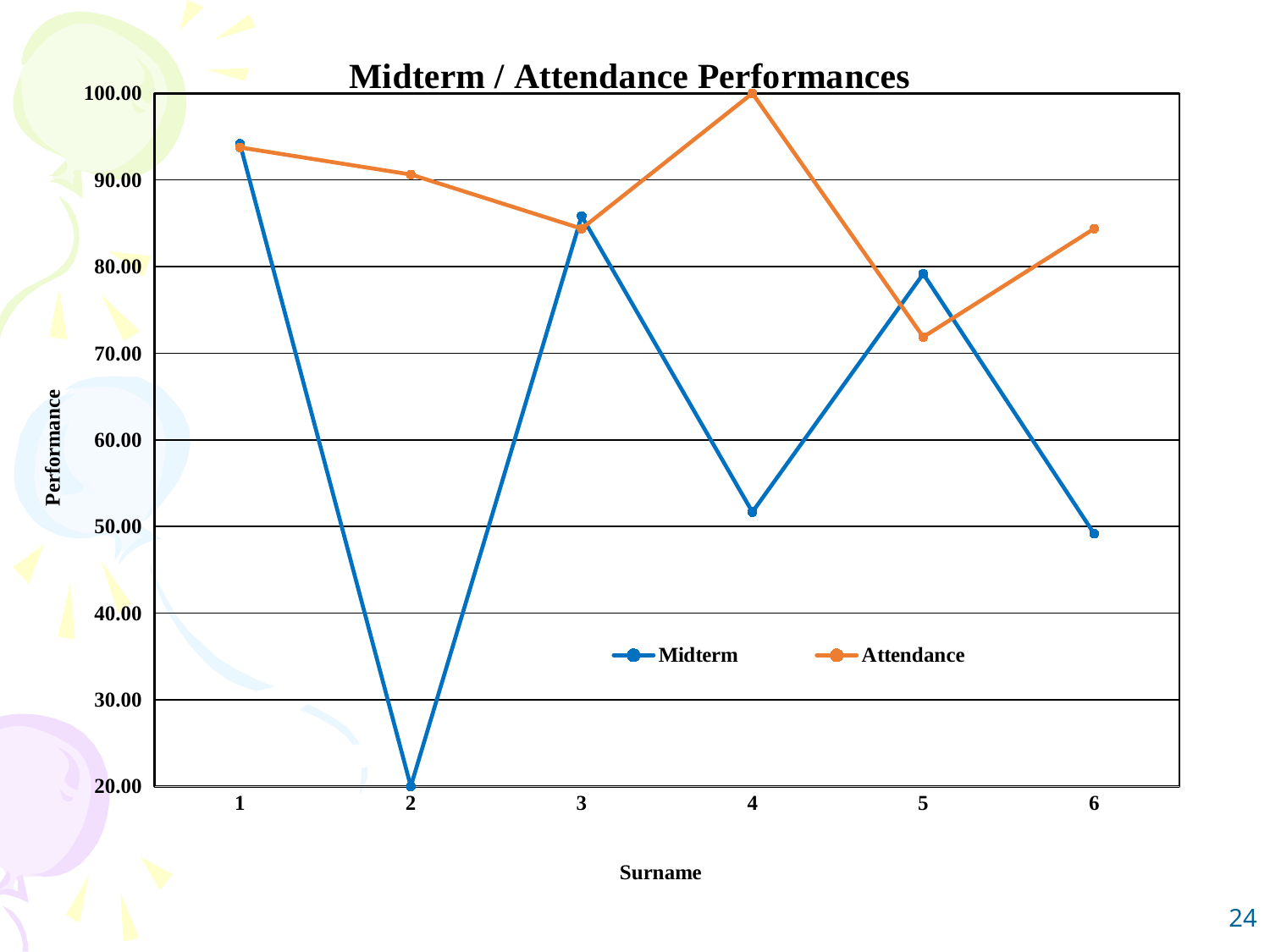
For which surname number is the Attendance value highest? 4 Which is larger for surname number 6, the Midterm value or the Attendance value? Attendance For which surname number is the Midterm value lowest? 2 What is the title of the chart? Midterm / Attendance Performances What is the label of the y axis? Performance What is the Attendance value for surname number 4? 100.00 What kind of chart is shown on the slide? line chart For which surname number is the Attendance value lowest? 5 How many points are plotted along the x axis for each series? 6 Is the Midterm value for surname number 4 greater or less than 60.00? less For which surname number is the Midterm value highest? 1 How many series does the legend list? 2